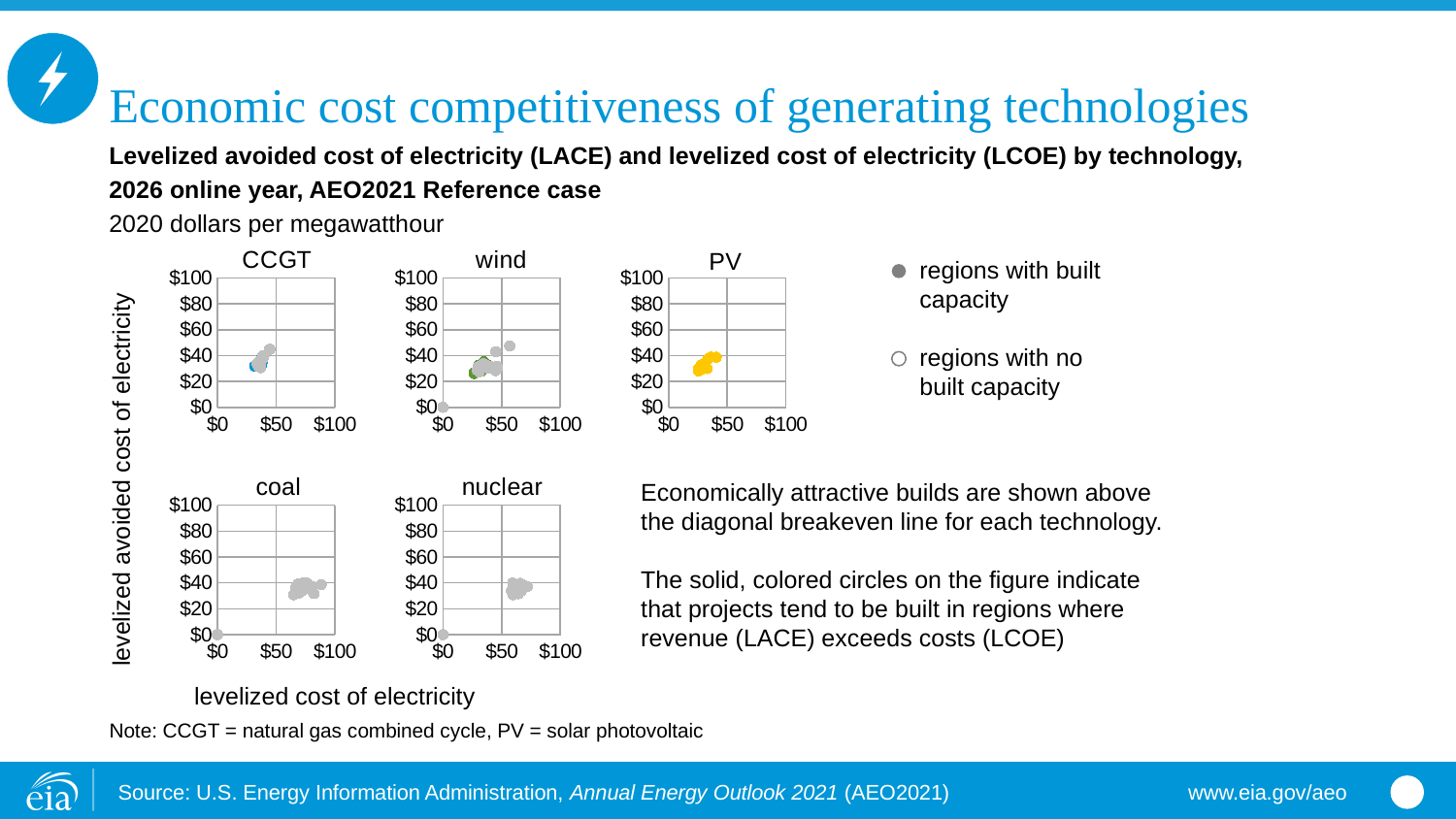
In the coal chart, are the levelized avoided cost of electricity values of the plotted points greater or less than $60? less In the PV chart, are the levelized cost of electricity values of the plotted points greater or less than $60? less What kind of chart is used for each of the five technology panels on the slide? scatter chart In the coal chart, are the levelized cost of electricity values of the plotted points greater or less than $50? greater What are the titles of the five charts on the slide? CCGT, wind, PV, coal, nuclear What does a solid circle represent according to the legend? regions with built capacity How many technology charts are shown on the slide? 5 How many series does the legend list? 2